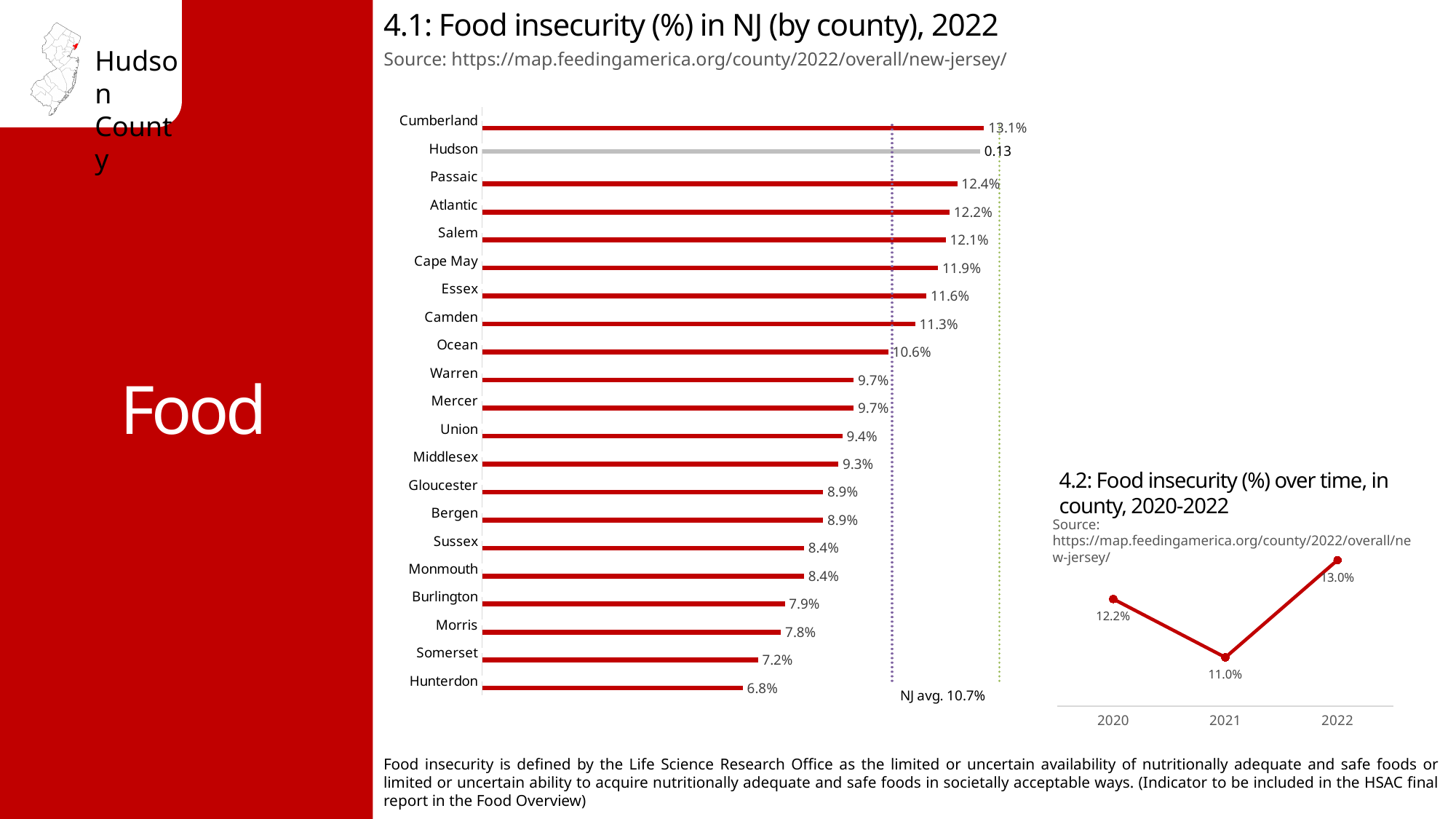
In chart 4.2, what is the difference between the 2022 and 2020 values? 0.8% What kind of chart is chart 4.2? Line chart In chart 4.1, what is the difference between the values for Passaic and Somerset? 5.2% In chart 4.1, what is the food insecurity value for Cumberland? 13.1% In chart 4.1, what NJ average value is labelled on the chart? 10.7% What kind of chart is chart 4.1? Bar chart In chart 4.1, which county has the lowest food insecurity value? Hunterdon In chart 4.2, what is the food insecurity value for 2021? 11.0% In chart 4.2, which year has the highest food insecurity value? 2022 In chart 4.1, how many counties are plotted? 21 In chart 4.1, which has the larger value, Essex or Ocean? Essex In chart 4.1, what is the food insecurity value for Hunterdon? 6.8%